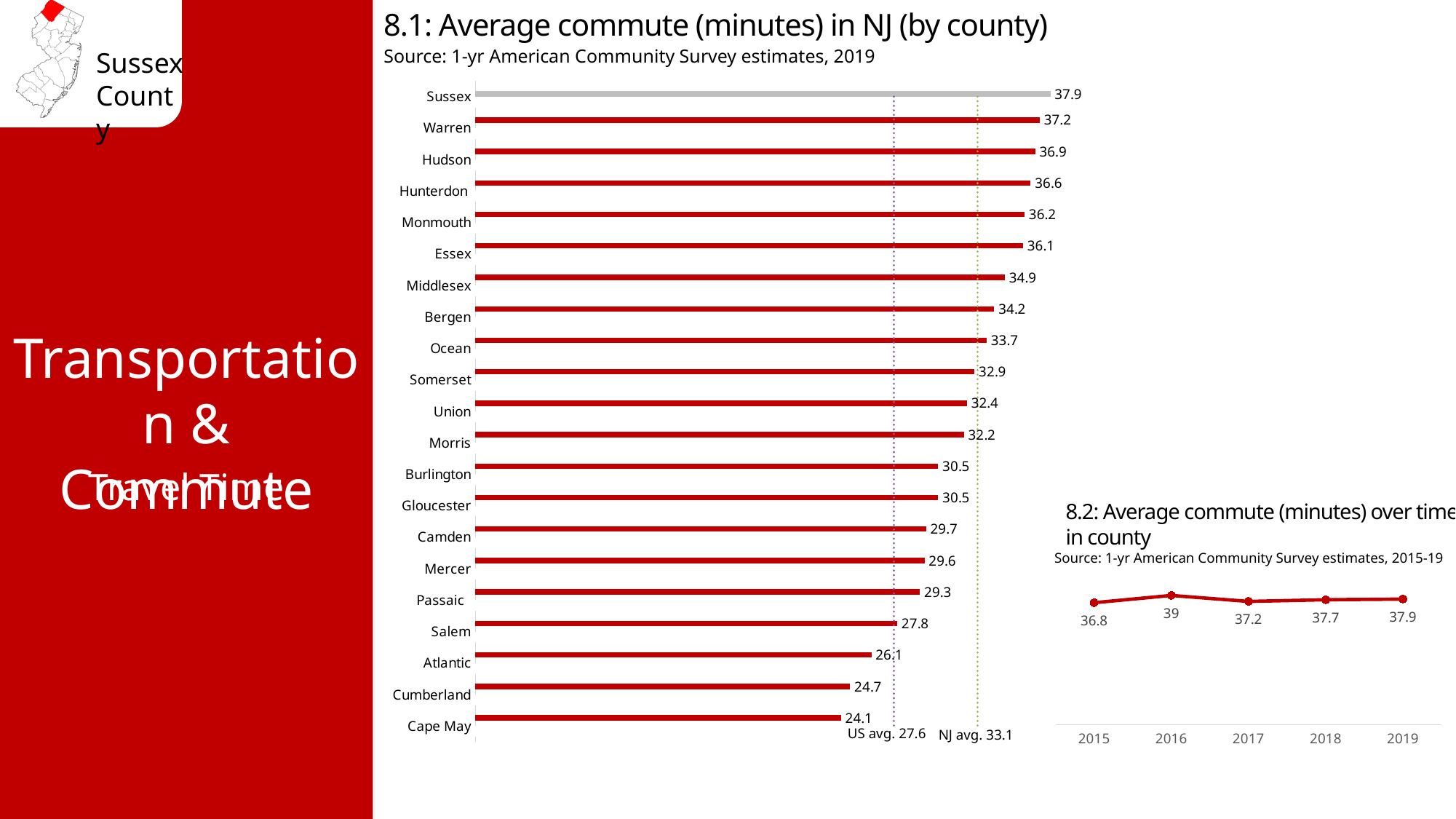
In chart 8.1, which county has a longer average commute, Hudson or Bergen? Hudson In chart 8.1, what is the NJ average commute shown by the dotted reference line? 33.1 In chart 8.1, how many counties are shown? 21 In chart 8.1, what is the difference between the average commute for Sussex and Cape May? 13.8 In chart 8.1, what is the average commute in minutes for Sussex County? 37.9 In chart 8.2, how many data points are plotted? 5 What kind of chart is chart 8.2? Line chart In chart 8.1, which county has the highest average commute? Sussex In chart 8.2, what was the average commute in 2016? 39 In chart 8.1, what is the average commute in minutes for Cape May? 24.1 In chart 8.1, which county has the lowest average commute? Cape May In chart 8.2, which year had the highest average commute? 2016